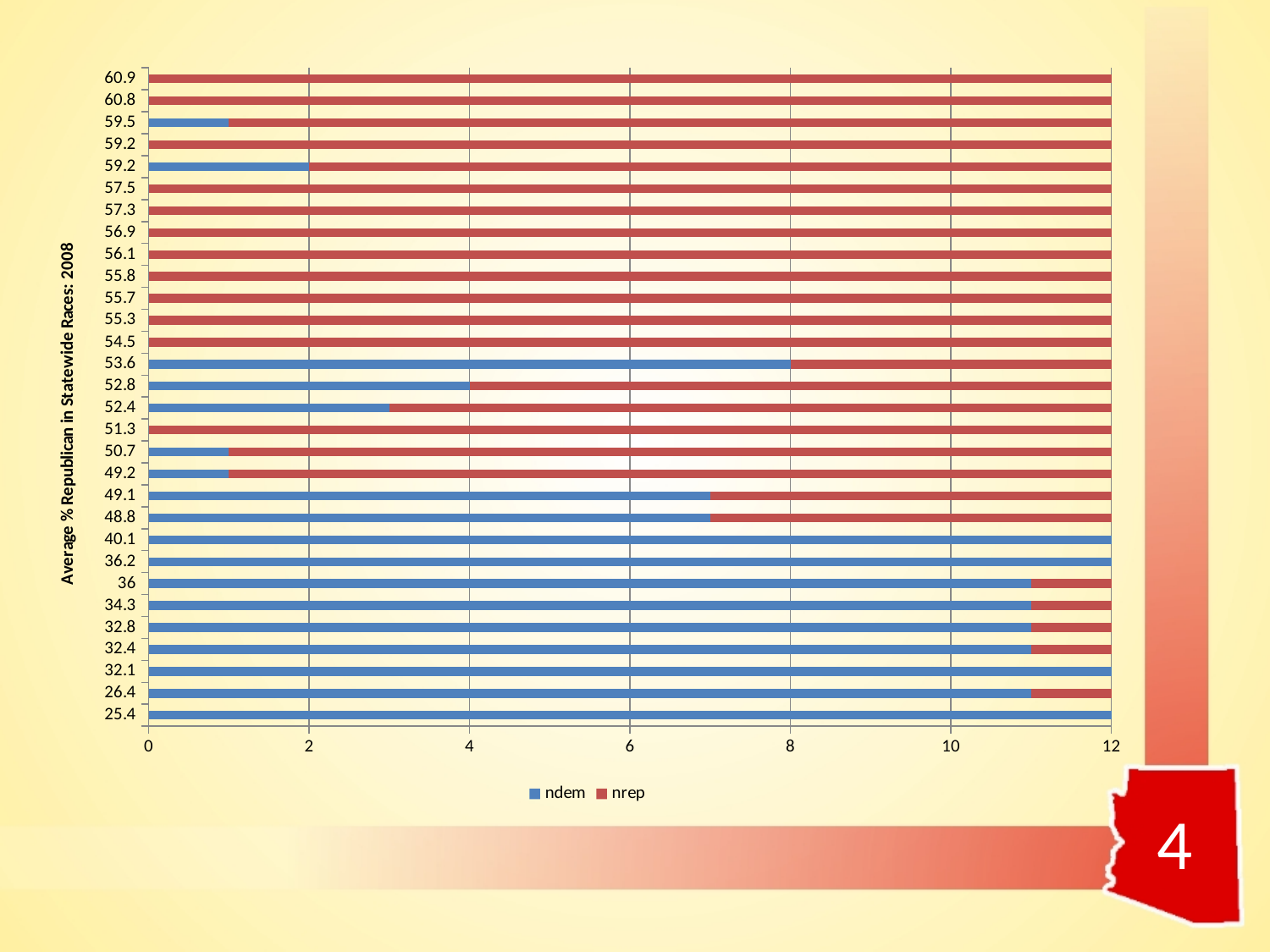
What are the two series named in the legend? ndem and nrep What is the title of the vertical axis? Average % Republican in Statewide Races: 2008 Which has the larger ndem value, the 53.6 category or the 52.8 category? 53.6 How many categories are plotted on the vertical axis? 30 What is the ndem value for the 52.8 category? 4 What is the nrep value for the 60.9 category? 12 How many series does the legend list? 2 What kind of chart is shown on the slide? bar chart Is the ndem value for the 25.4 category greater or less than 10? greater What is the ndem value for the 53.6 category? 8